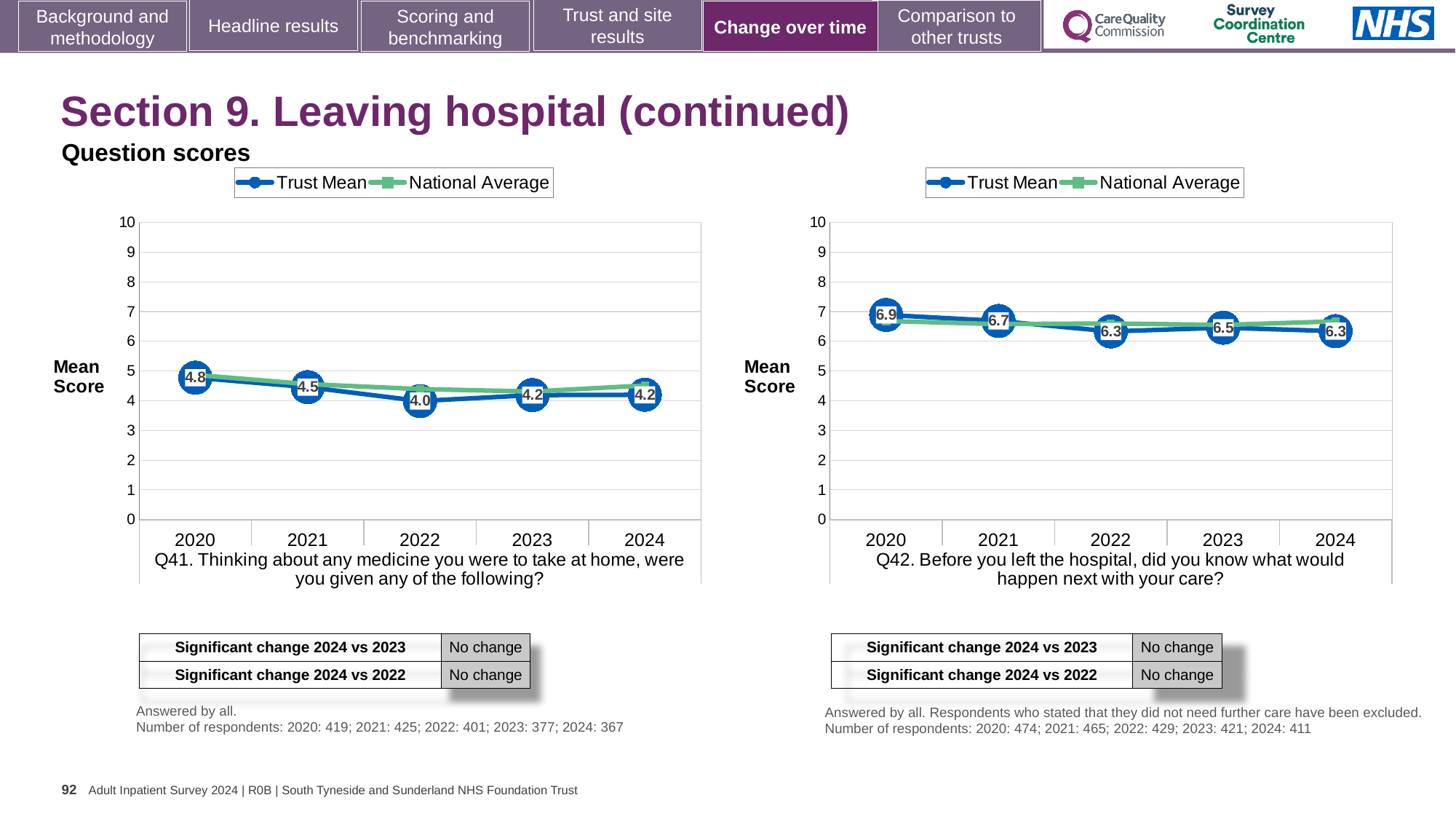
In the Q42 chart, what is the Trust Mean score for 2023? 6.5 In the Q41 chart, is the Trust Mean score for 2021 greater or less than 5? less In the Q42 chart, how many years are plotted on the x axis? 5 What type of chart is the Q42 chart? Line chart How many series does the legend of the Q41 chart list? 2 In the Q41 chart, which year has the lowest Trust Mean score? 2022 In the Q41 chart, what is the difference between the Trust Mean scores for 2020 and 2022? 0.8 In the Q41 chart, what is the Trust Mean score for 2020? 4.8 In the Q41 chart, what is the Trust Mean score for 2022? 4.0 In the Q42 chart, what is the Trust Mean score for 2020? 6.9 In the Q42 chart, is the Trust Mean score for 2021 larger than the Trust Mean score for 2022? Yes In the Q42 chart, which year has the highest Trust Mean score? 2020